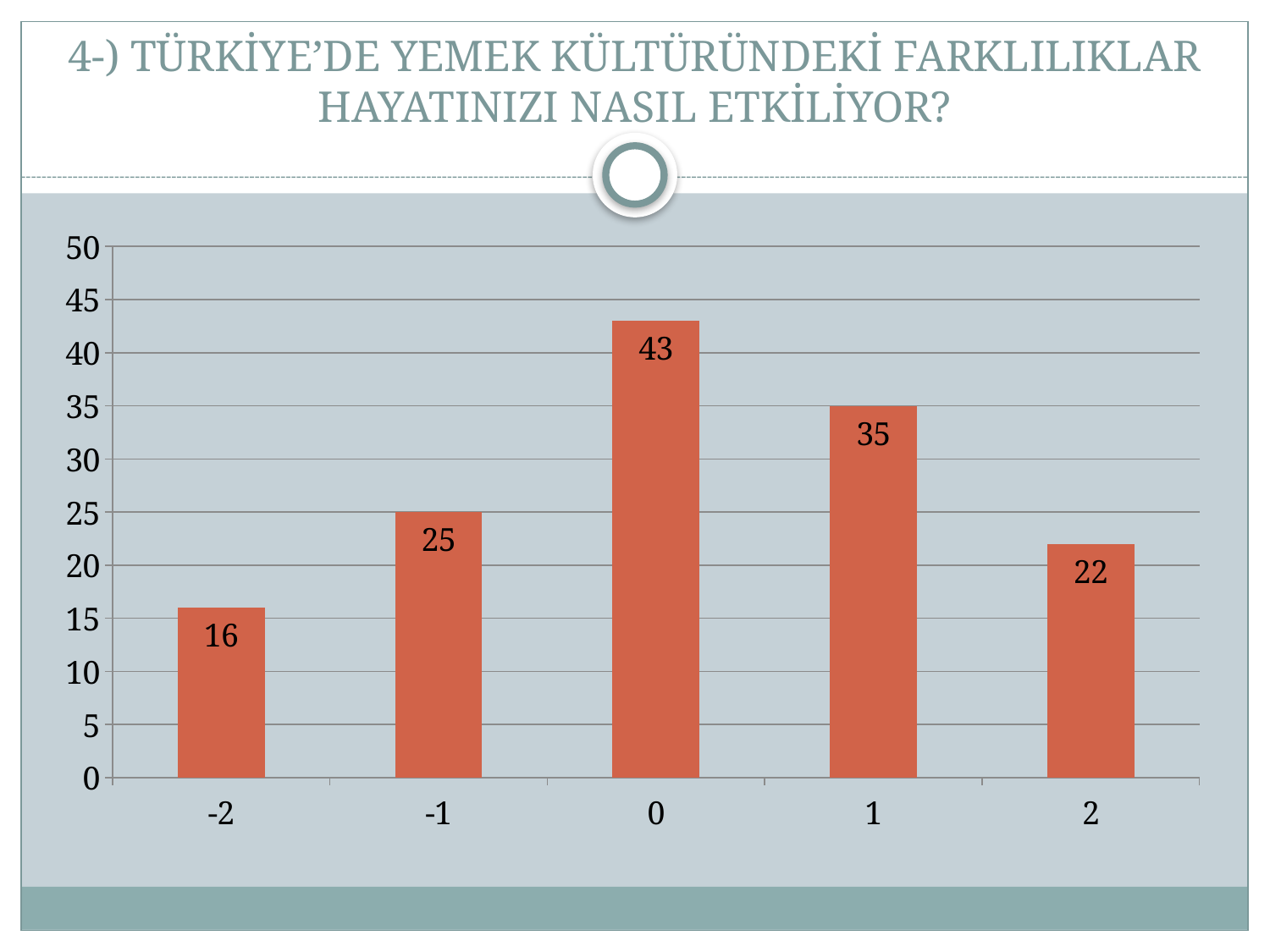
Which category has the lowest value? -2 What is the value for category -2? 16 What is the difference between the values for -1 and -2? 9 What is the value for category 2? 22 What kind of chart is shown on the slide? bar chart Which category has the highest value? 0 What is the difference between the values for 0 and 1? 8 What is the value for category 0? 43 Which is larger, the value for -1 or the value for 2? -1 What is the value for category 1? 35 How many categories are shown on the x axis? 5 Is the value for 1 greater or less than 30? greater